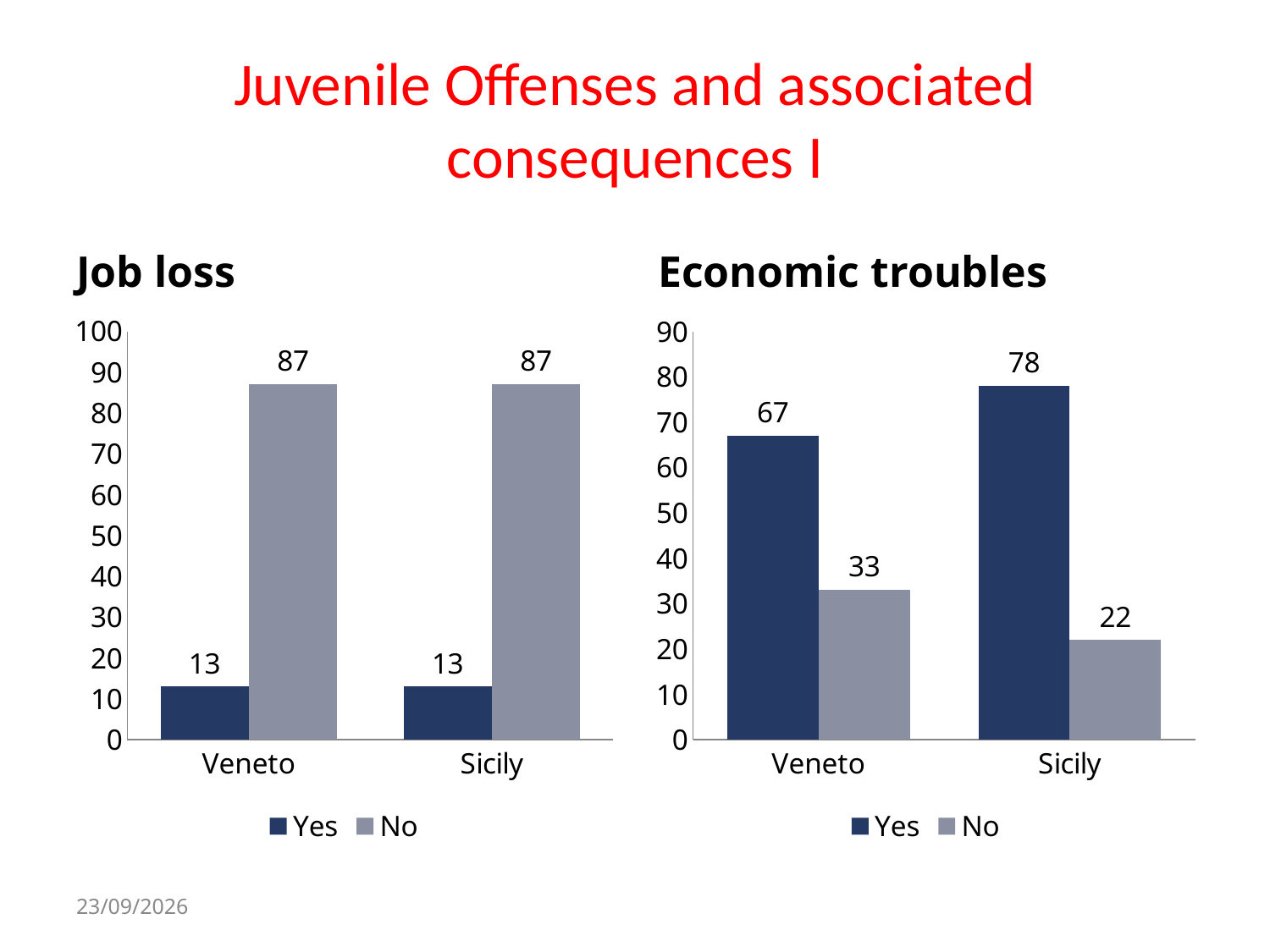
In the Economic troubles chart, is the No value for Veneto larger or smaller than the No value for Sicily? larger In the Economic troubles chart, which bar has the lowest value? No in Sicily How many series does the legend of the Job loss chart list? 2 What kind of chart is the Job loss chart? Bar chart In the Economic troubles chart, what is the difference between Yes and No in Veneto? 34 How many categories are shown on the x axis of the Economic troubles chart? 2 In the Job loss chart, what is the value for No in Veneto? 87 In the Job loss chart, what is the value for Yes in Sicily? 13 In the Economic troubles chart, what is the value for No in Sicily? 22 In the Economic troubles chart, what is the value for Yes in Veneto? 67 In the Job loss chart, what is the difference between No and Yes in Sicily? 74 In the Economic troubles chart, which region has the higher Yes value? Sicily